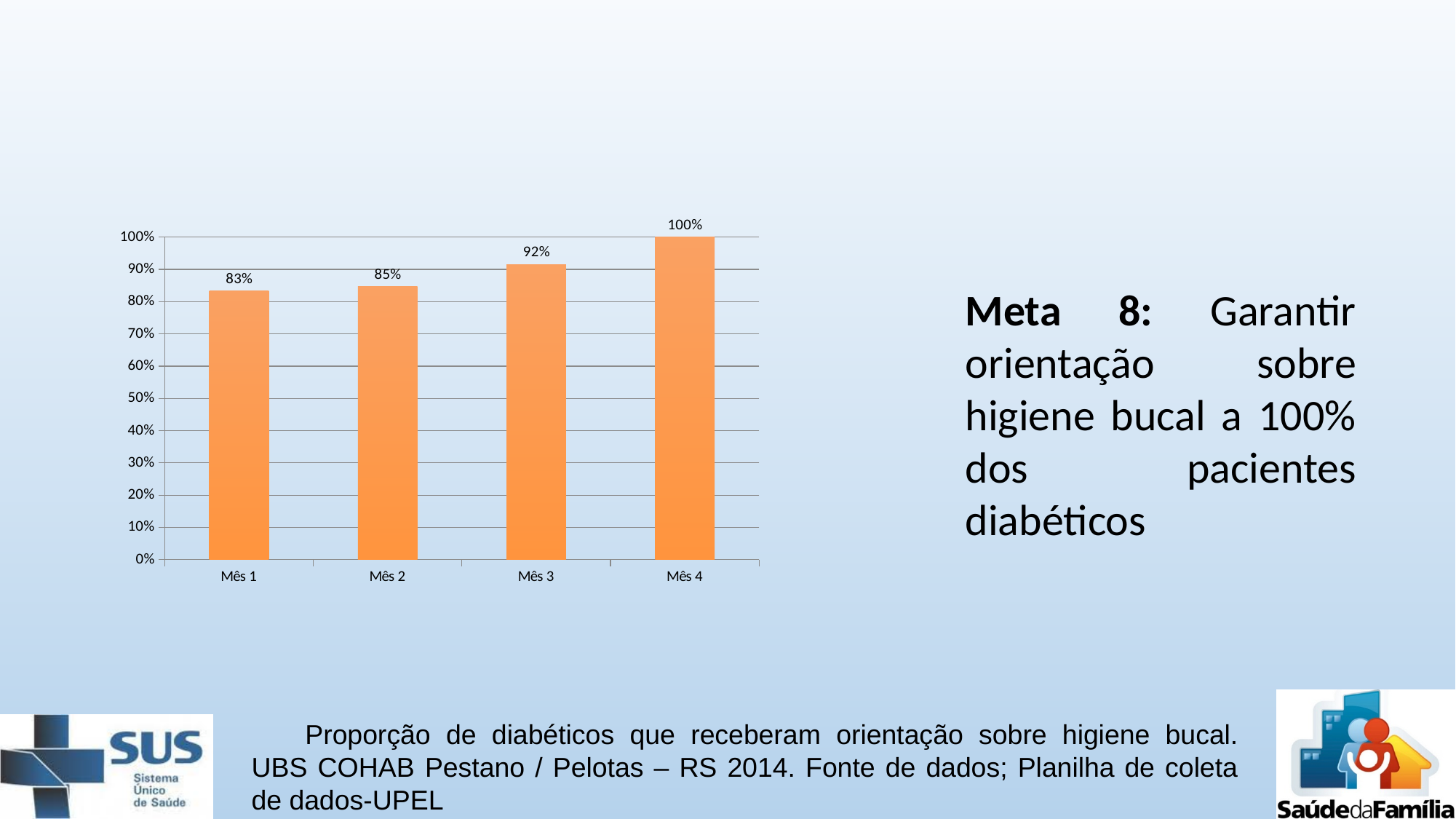
Which month has the lowest value? Mês 1 How many months are shown on the x axis? 4 What is the value for Mês 3? 92% Which month has the highest value? Mês 4 What is the value for Mês 4? 100% Do the values rise or fall from Mês 1 to Mês 4? rise What is the difference between the values for Mês 4 and Mês 1? 17% What is the value for Mês 1? 83% Which is larger, the value for Mês 3 or the value for Mês 2? Mês 3 Is the value for Mês 2 greater or less than 90%? less What kind of chart is shown on the slide? bar chart What is the difference between the values for Mês 3 and Mês 2? 7%